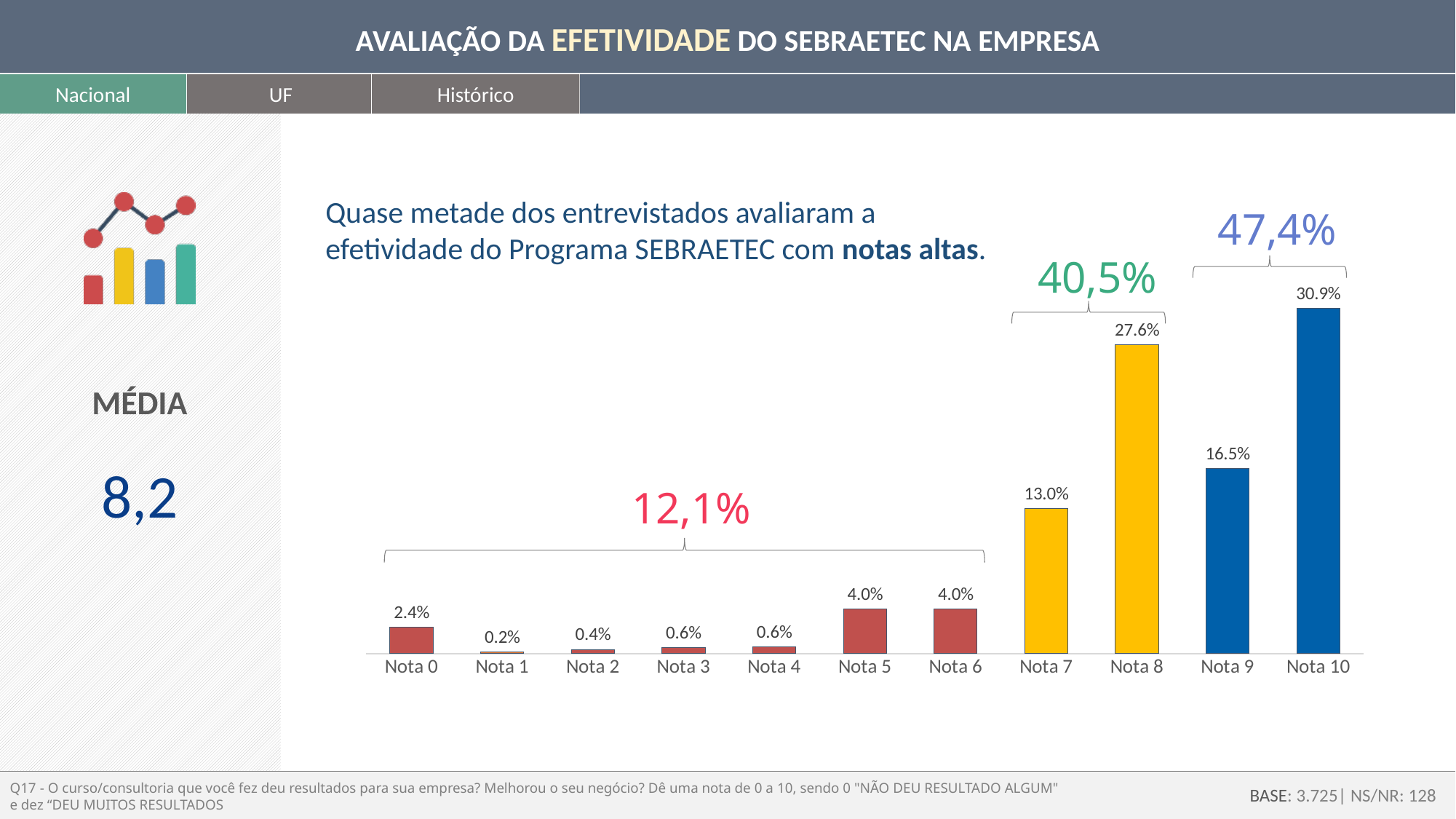
What is the value for Nota 10? 30.9% What is the value for Nota 8? 27.6% Which category has the highest value? Nota 10 How many categories are shown on the x axis? 11 What colour are the bars for Nota 7 and Nota 8? yellow What is the difference between the values for Nota 10 and Nota 9? 14.4% Which category has the lowest value? Nota 1 What is the difference between the values for Nota 8 and Nota 7? 14.6% What combined percentage is shown above the bracket covering Nota 9 and Nota 10? 47,4% What kind of chart is shown on the slide? bar chart Which is larger, the value for Nota 7 or the value for Nota 9? Nota 9 What is the value for Nota 1? 0.2%